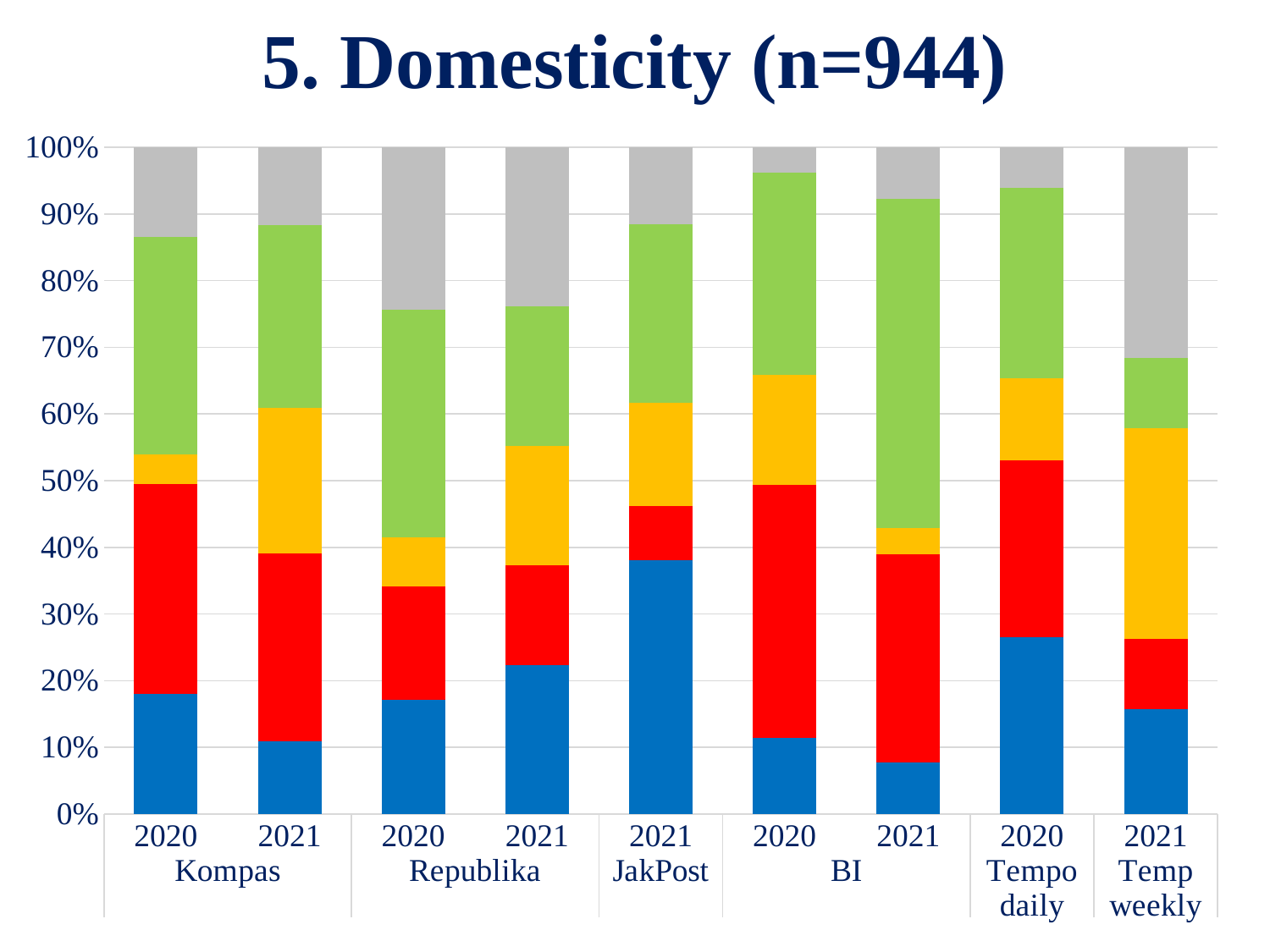
Is the blue segment for JakPost 2021 greater or less than 30%? greater Which bar has the smallest blue (bottom) segment? BI 2021 How many bars are plotted in the chart? 9 Which bar has the largest green segment? BI 2021 What kind of chart is shown on the slide? stacked bar chart Is the blue segment for BI 2021 greater or less than 10%? less Which bar has the largest grey (top) segment? Temp weekly 2021 What is the title of the chart? 5. Domesticity (n=944) Which has the larger red segment, Kompas 2020 or Republika 2020? Kompas 2020 How many publications are labelled along the x axis? 6 Which bar has the largest blue (bottom) segment? JakPost 2021 How many differently coloured segments make up each stacked bar? 5